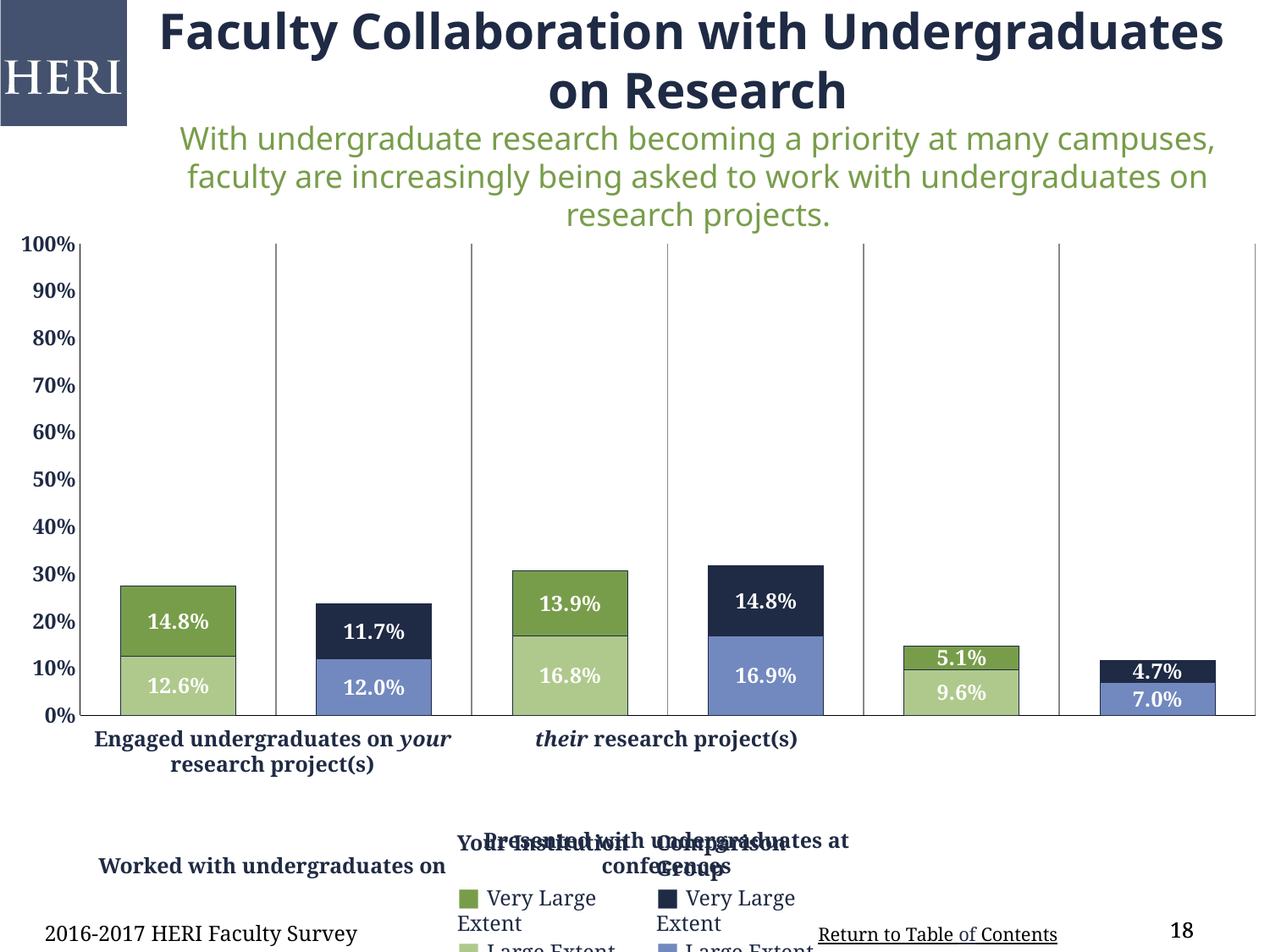
What is the 'Large Extent' value for Your Institution for 'Worked with undergraduates on their research project(s)'? 16.8% What is the 'Very Large Extent' value for Your Institution for 'Engaged undergraduates on your research project(s)'? 14.8% What is the total of the stacked bar for Your Institution for 'Engaged undergraduates on your research project(s)'? 27.4% How many categories are shown along the x axis? 3 What type of chart is shown on the slide? stacked bar chart Is the total stacked bar for Your Institution for 'Worked with undergraduates on their research project(s)' greater or less than 20%? greater What is the 'Large Extent' value for the Comparison Group for 'Engaged undergraduates on your research project(s)'? 12.0% What is the 'Very Large Extent' value for the Comparison Group for 'Worked with undergraduates on their research project(s)'? 14.8% What is the difference between the 'Very Large Extent' values for Your Institution and the Comparison Group for 'Engaged undergraduates on your research project(s)'? 3.1% What is the total of the stacked bar for the Comparison Group for 'Worked with undergraduates on their research project(s)'? 31.7% Which category has the lowest stacked bar total for the Comparison Group? Presented with undergraduates at conferences Which is larger for 'Presented with undergraduates at conferences': the 'Large Extent' value for Your Institution or for the Comparison Group? Your Institution